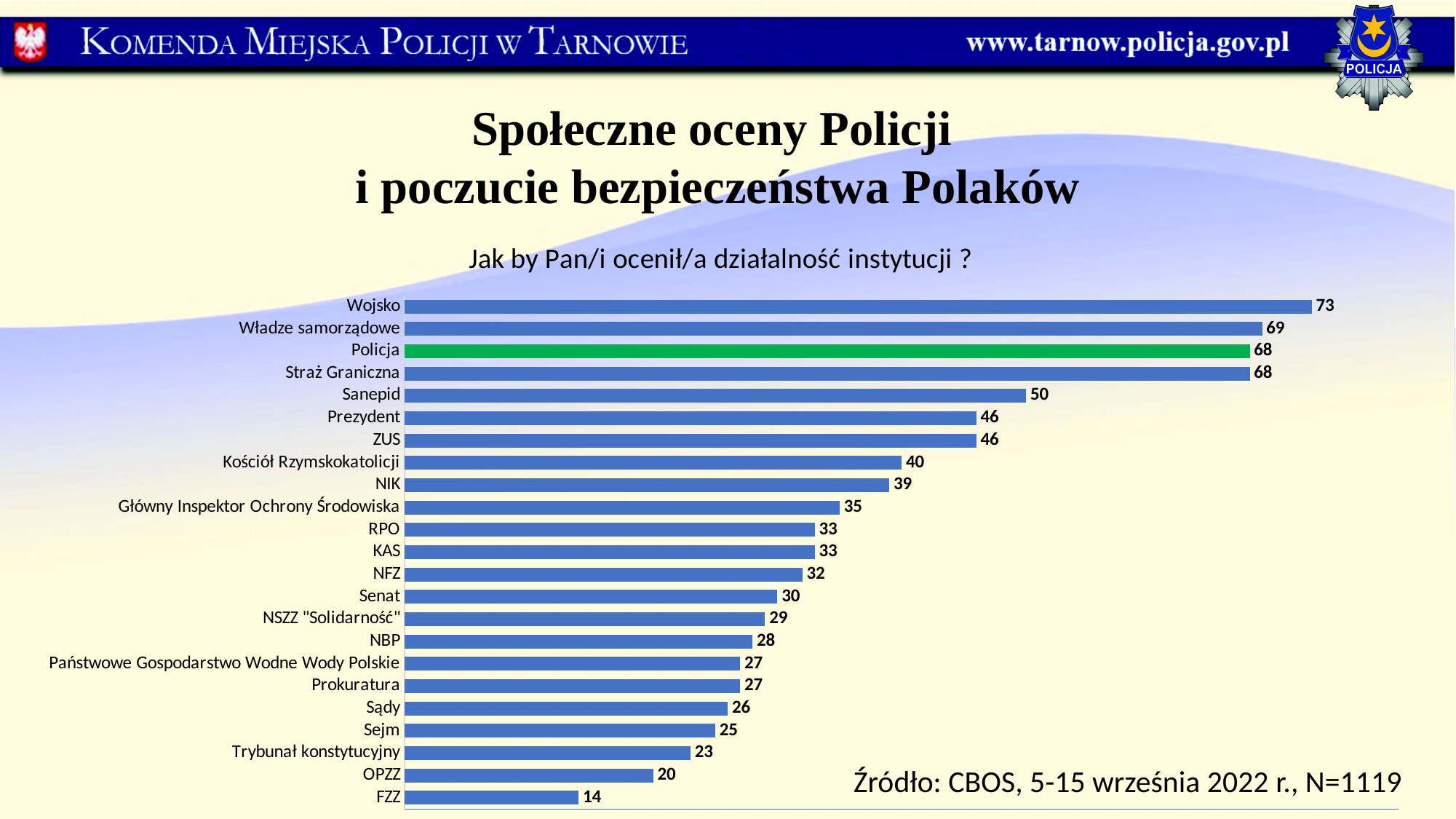
What is the value for Policja? 68 Which institution has the highest value? Wojsko Which has a larger value, Sanepid or Prezydent? Sanepid What kind of chart is shown on the slide? Bar chart Which has a larger value, Sejm or Senat? Senat What is the difference between the values for OPZZ and FZZ? 6 What is the difference between the values for Wojsko and Policja? 5 What is the value for Trybunał konstytucyjny? 23 What is the value for Sanepid? 50 How many institutions are shown in the chart? 23 Which institution has the lowest value? FZZ Which bar is coloured green instead of blue? Policja